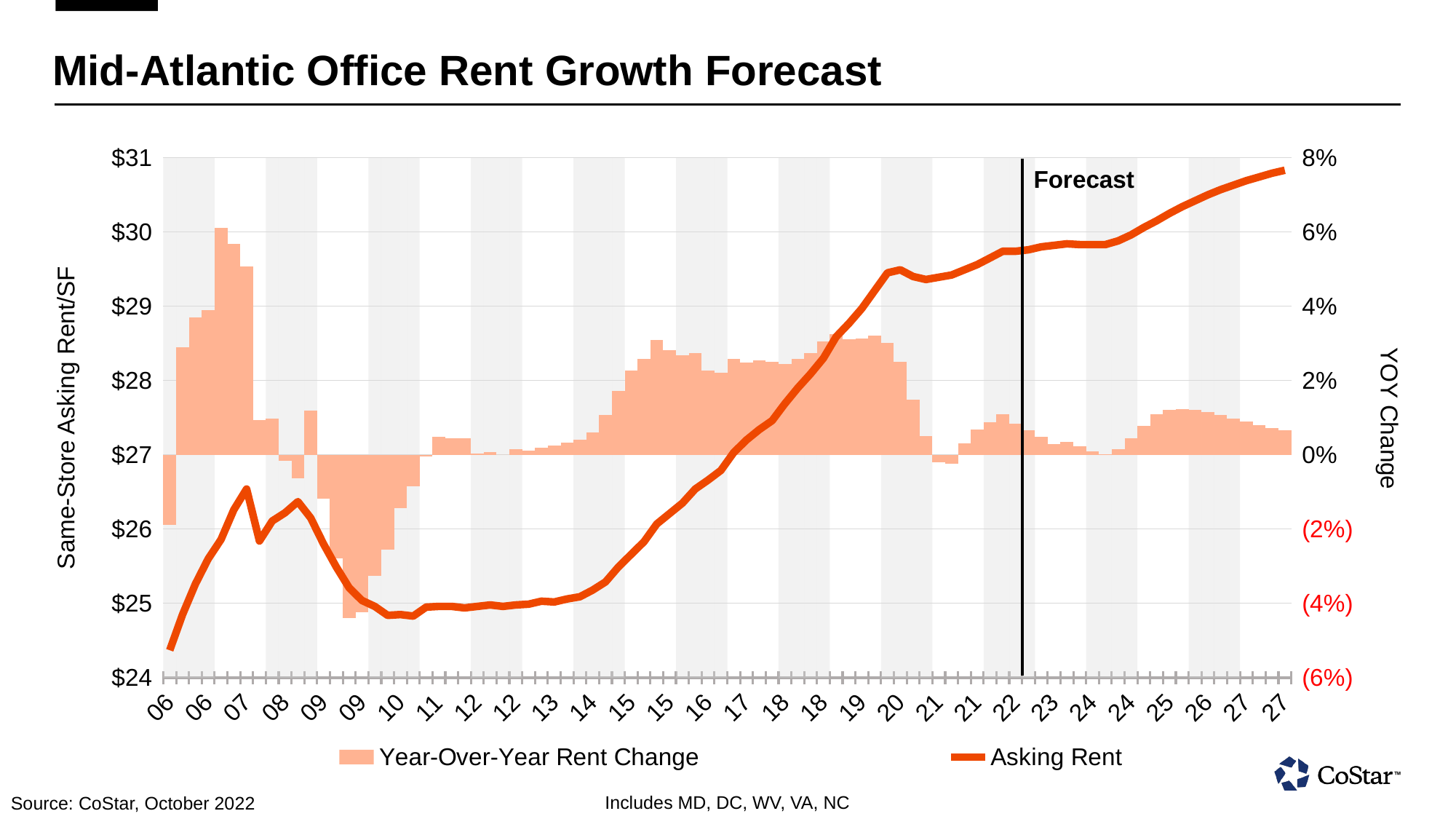
What is the title of the chart? Mid-Atlantic Office Rent Growth Forecast Does the Asking Rent line rise or fall from 22 to 27? rise What are the two series named in the legend? Year-Over-Year Rent Change and Asking Rent Does the Asking Rent line rise or fall from 08 to 10? fall How many series does the legend list? 2 Is the Asking Rent value at the end of 27 greater or less than $30? greater Is the Asking Rent value at 10 greater or less than $25? less Is the Asking Rent value at the start of 06 greater or less than $25? less Which is larger, the Asking Rent at 27 or the Asking Rent at 06? 27 What kind of chart is used to plot the Asking Rent series? line chart